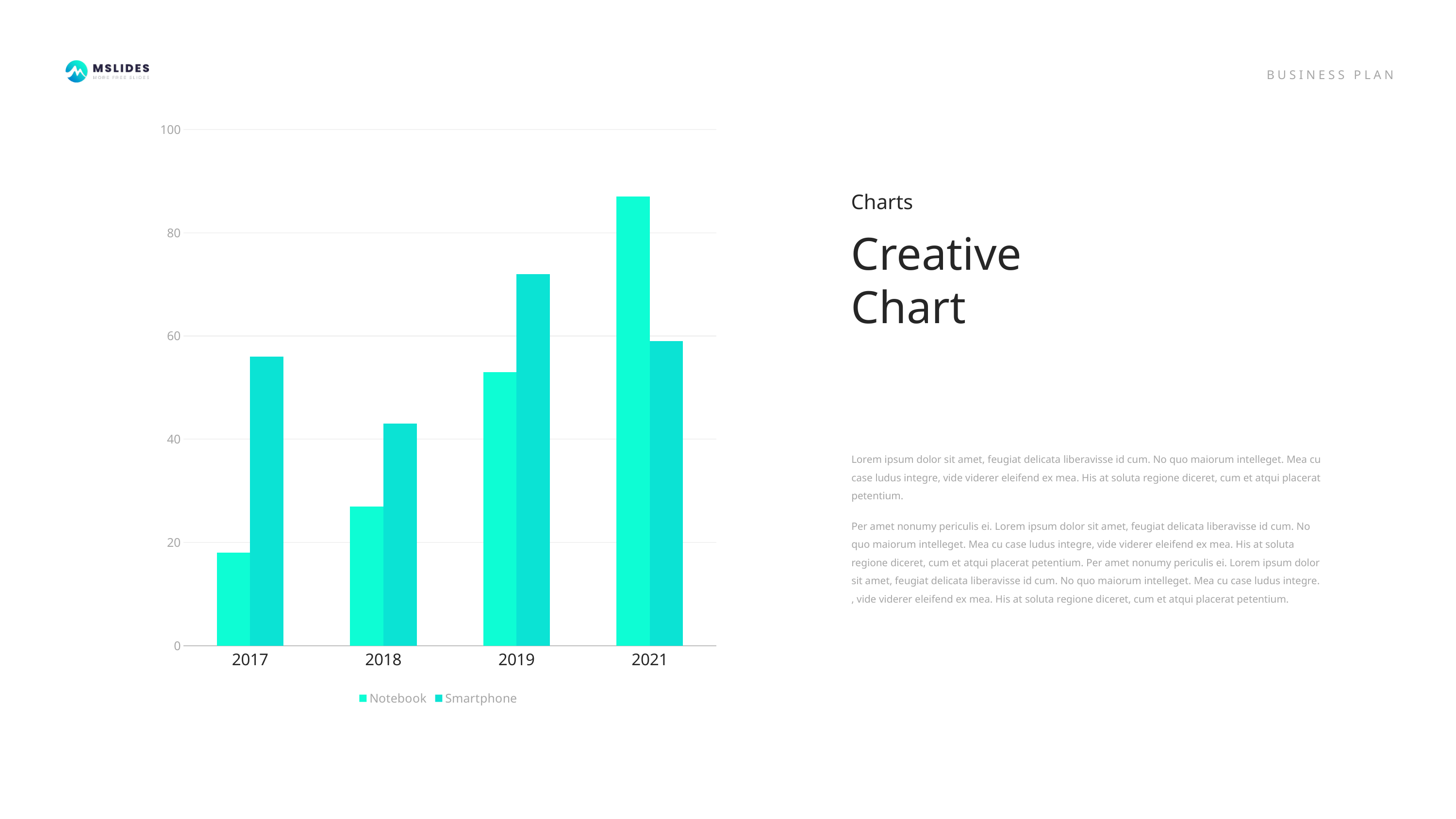
Which series are listed in the legend? Notebook and Smartphone In which year is the Smartphone value highest? 2019 How many series does the legend list? 2 In which year is the Smartphone value lowest? 2018 Do the Notebook values rise or fall from 2017 to 2021? rise In 2017, which is larger, Notebook or Smartphone? Smartphone Is the Notebook value for 2021 greater or less than 80? greater In which year is the Notebook value highest? 2021 How many categories are shown on the x axis? 4 What kind of chart is shown on the slide? bar chart In which year is the Notebook value lowest? 2017